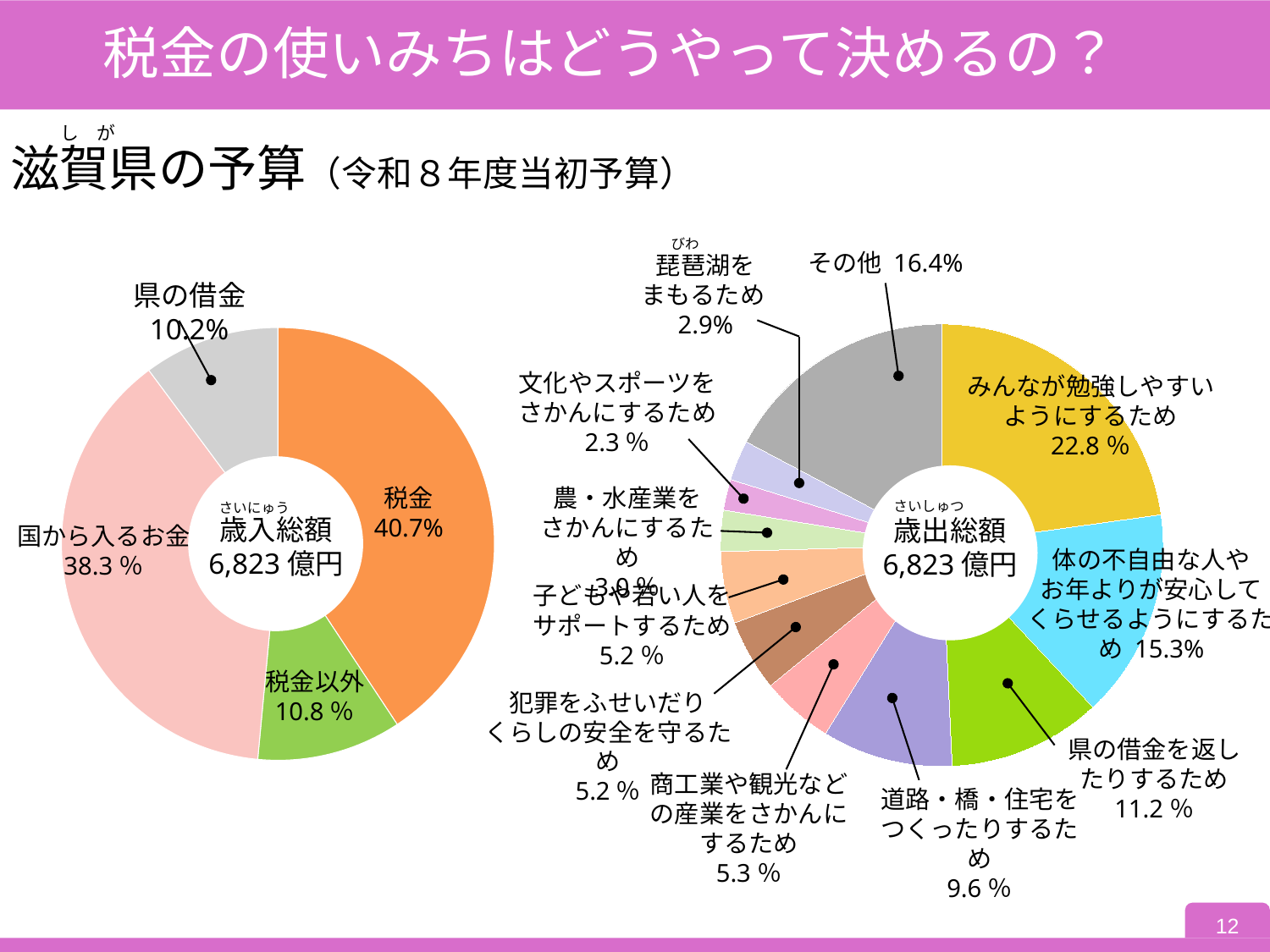
In the 歳出総額 chart on the right, how many slices are there? 11 In the 歳入総額 chart on the left, which category has the smallest share? 県の借金 In the 歳入総額 chart on the left, how many categories are shown? 4 In the 歳入総額 chart on the left, what share is 税金? 40.7% What kind of chart is the 歳入総額 chart on the left? Pie (donut) chart What total amount is shown in the centre of the 歳出総額 chart on the right? 6,823 億円 In the 歳出総額 chart on the right, what share is 道路・橋・住宅をつくったりするため? 9.6 % In the 歳出総額 chart on the right, which is larger: 県の借金を返したりするため or 商工業や観光などの産業をさかんにするため? 県の借金を返したりするため In the 歳出総額 chart on the right, what share is みんなが勉強しやすいようにするため? 22.8 % In the 歳入総額 chart on the left, what is the difference between 税金以外 and 県の借金? 0.6 percentage points In the 歳入総額 chart on the left, what share is 国から入るお金? 38.3 % In the 歳出総額 chart on the right, which named purpose (excluding その他) has the largest share? みんなが勉強しやすいようにするため